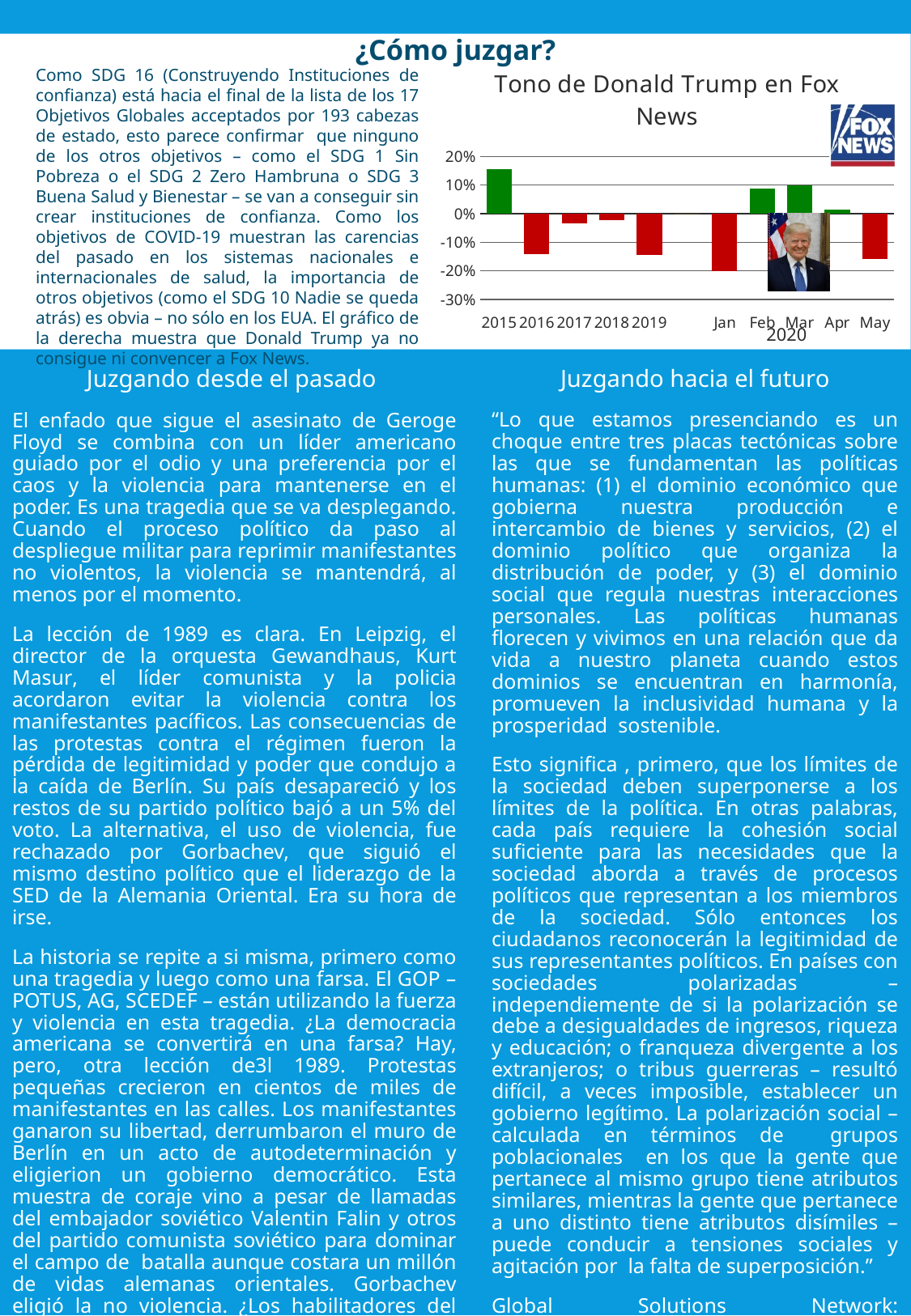
In the 'Tono de Donald Trump en Fox News' chart, which category has the highest value? 2015 In the 'Tono de Donald Trump en Fox News' chart, which is larger, the value for 2015 or the value for 2016? 2015 In the 'Tono de Donald Trump en Fox News' chart, is the value for Jan 2020 greater or less than -10%? less In the 'Tono de Donald Trump en Fox News' chart, is the value for 2019 greater or less than 0%? less In the 'Tono de Donald Trump en Fox News' chart, which is larger, the value for Mar 2020 or the value for Jan 2020? Mar 2020 In the 'Tono de Donald Trump en Fox News' chart, is the value for 2015 greater or less than 10%? greater What kind of chart is 'Tono de Donald Trump en Fox News'? bar chart What is the title of the chart on the slide? Tono de Donald Trump en Fox News In the 'Tono de Donald Trump en Fox News' chart, which category has the lowest value? Jan 2020 How many bars (categories) are plotted in the 'Tono de Donald Trump en Fox News' chart? 10